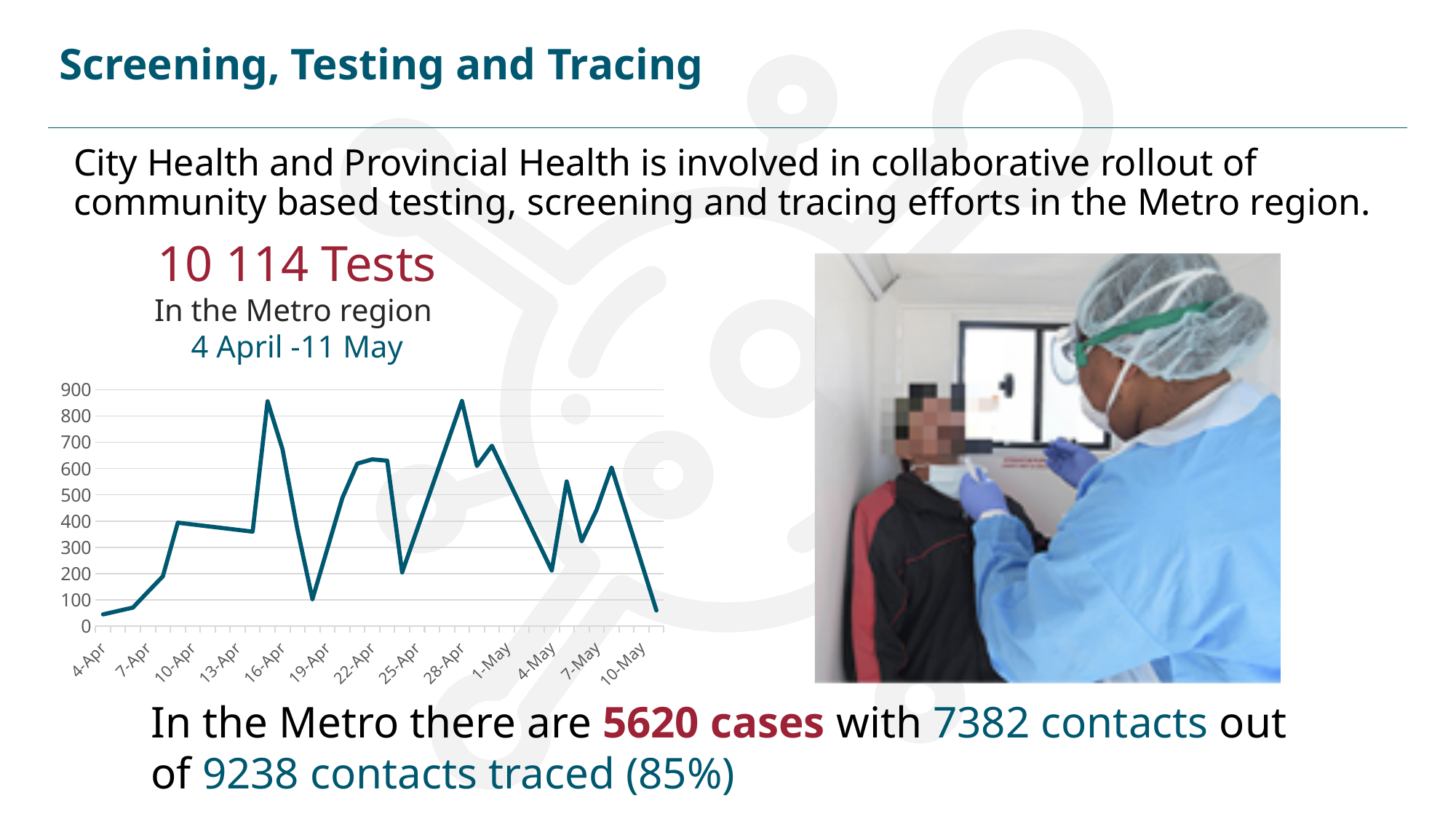
Which is larger, the value for 16-Apr or the value for 19-Apr? 16-Apr Is the value for 4-Apr greater or less than 100? less What is the highest value shown on the chart's y axis? 900 Is the value for 4-May greater or less than 300? less Is the value for 22-Apr greater or less than 500? greater Between 4-Apr and 16-Apr, do the values generally rise or fall? rise How many date labels are shown on the x axis of the chart? 13 What kind of chart is shown on the slide? line chart